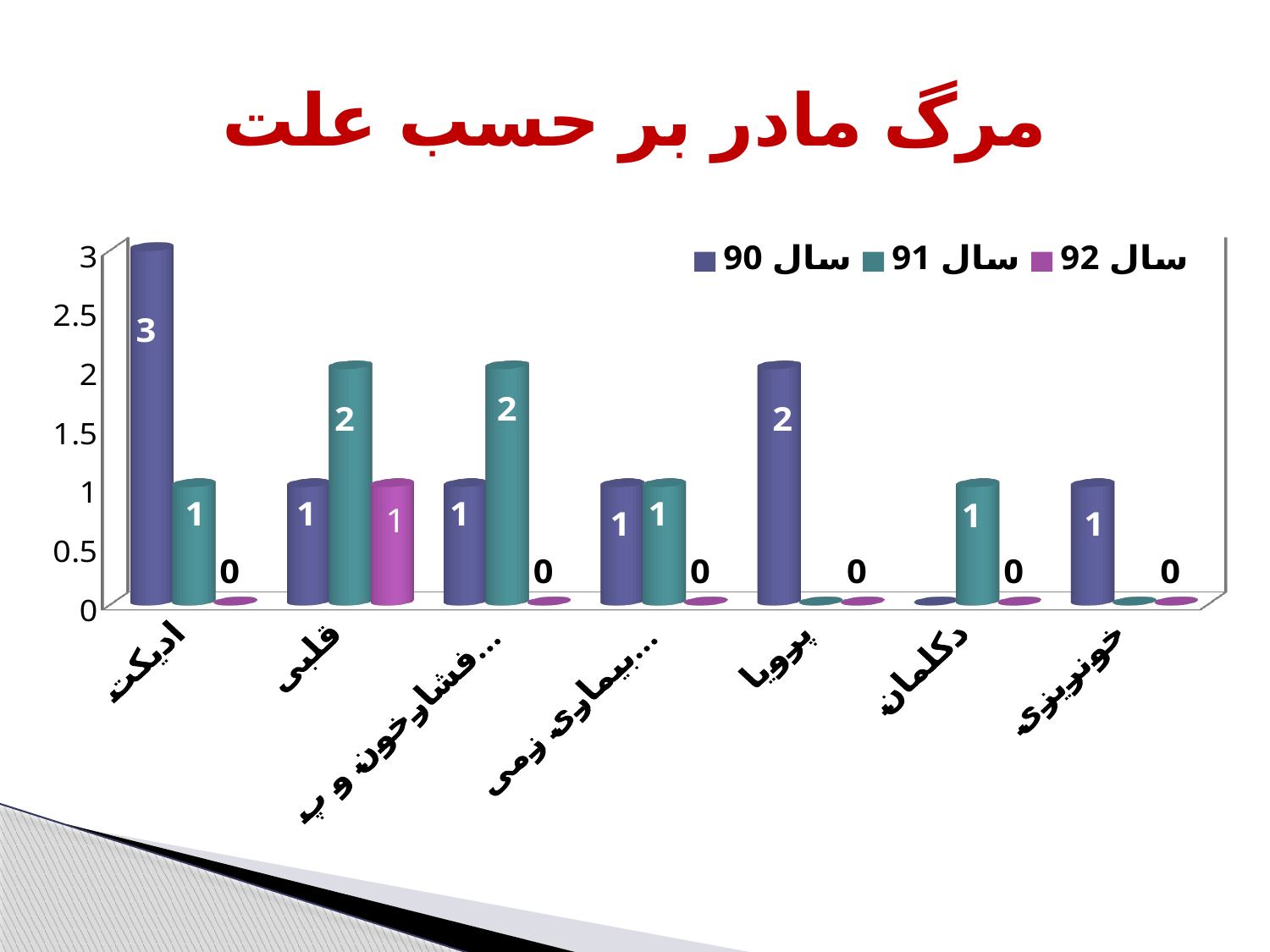
What type of chart is shown on the slide? bar chart Which is larger in the فشارخون category: the value for سال 90 or سال 91? سال 91 What is the value for سال 90 in the پرویا category? 2 What is the difference between the سال 90 and سال 91 values in the ادیکت category? 2 What is the value for سال 90 in the ادیکت category? 3 Which category has the highest value for سال 90? ادیکت What is the value for سال 91 in the دکلمان category? 1 How many series does the legend list? 3 How many categories are shown on the x axis? 7 What is the value for سال 91 in the قلبی category? 2 What is the title of the chart? مرگ مادر بر حسب علت What is the value for سال 92 in the قلبی category? 1